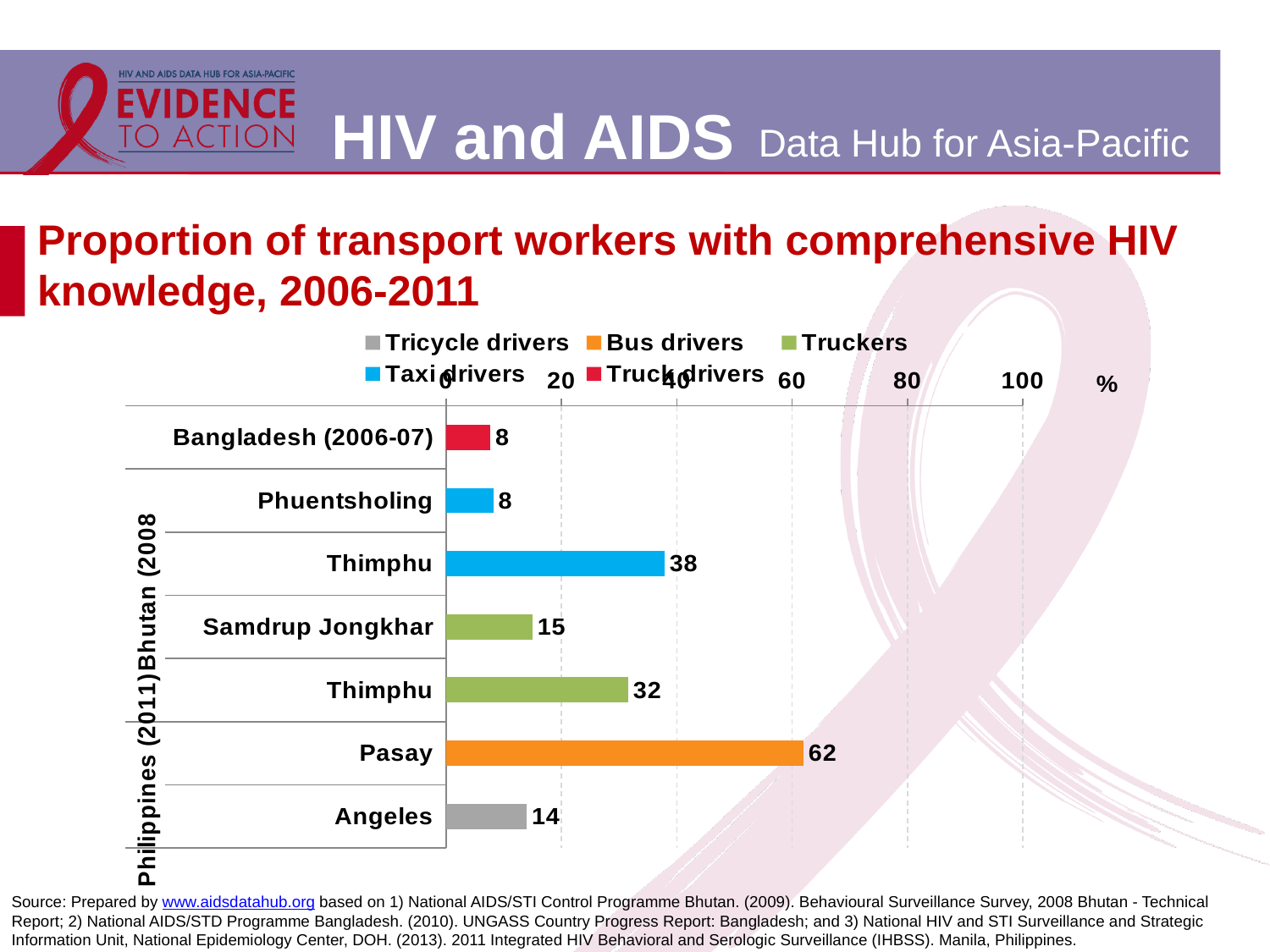
What is the difference between the Thimphu taxi drivers value and the Thimphu truckers value? 6 What is the value for Pasay? 62 What is the value for Angeles? 14 What kind of chart is shown on the slide? Bar chart What is the difference between the value for Pasay and the value for Angeles? 48 What is the value for Thimphu in the Taxi drivers series (blue bar)? 38 Which is larger, the value for Samdrup Jongkhar or the value for Angeles? Samdrup Jongkhar What is the value for Samdrup Jongkhar? 15 What is the value for Bangladesh (2006-07)? 8 Which category has the highest value? Pasay How many series does the legend list? 5 How many bars are plotted in the chart? 7